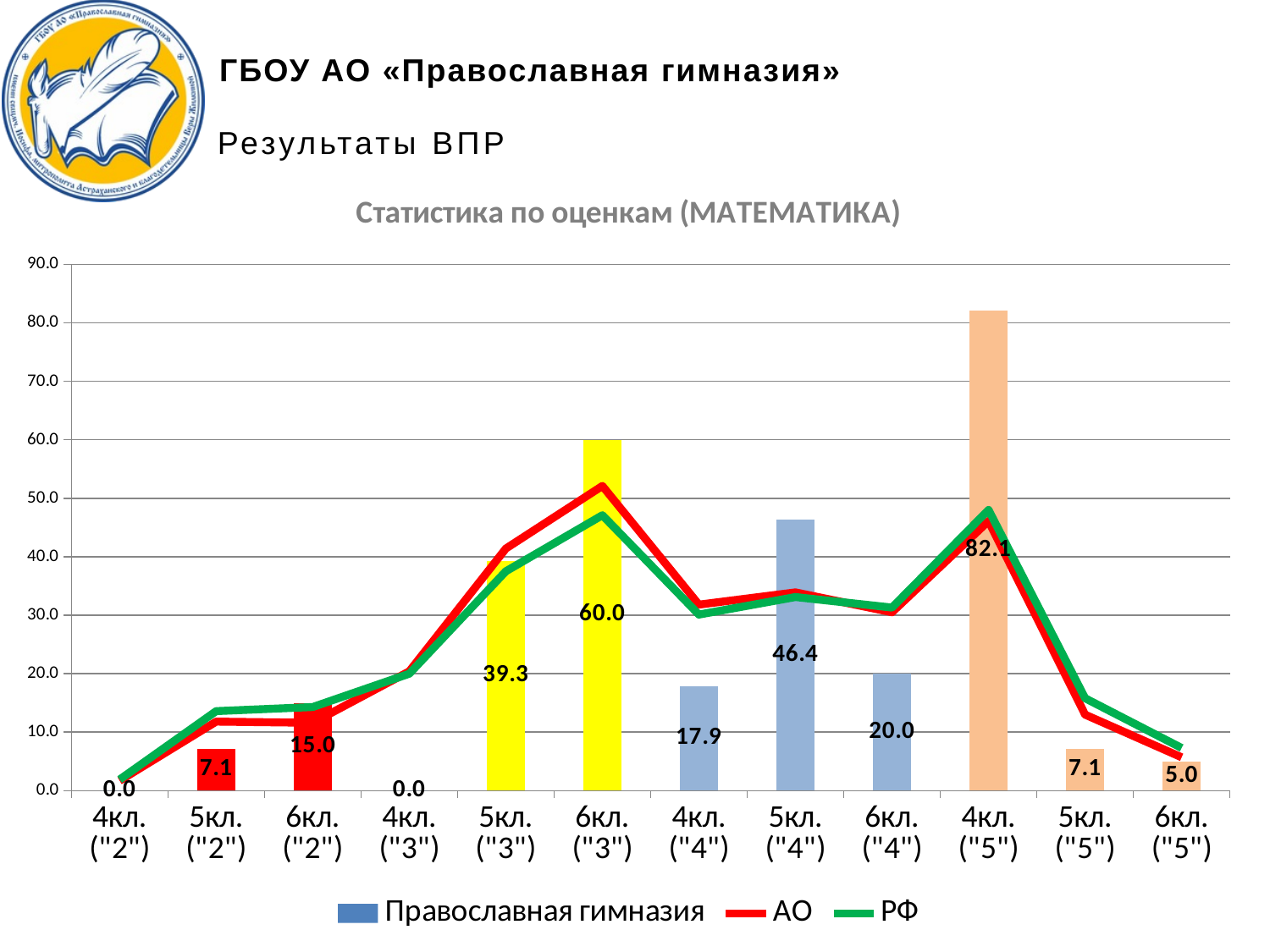
Is the РФ value for 4кл. ("3") greater or less than 30.0? less Which is larger for Православная гимназия: the value for 6кл. ("2") or the value for 5кл. ("2")? 6кл. ("2") How many series does the legend list? 3 How many categories are shown on the x axis? 12 Which category has the highest bar for Православная гимназия? 4кл. ("5") What kind of chart is used for the Православная гимназия series? bar chart What is the value for Православная гимназия in the category 5кл. ("4")? 46.4 Is the АО value for 6кл. ("3") greater or less than 50.0? greater What is the value for Православная гимназия in the category 4кл. ("5")? 82.1 What is the value for Православная гимназия in the category 6кл. ("3")? 60.0 What is the title of the chart? Статистика по оценкам (МАТЕМАТИКА) What is the difference between the Православная гимназия values for 6кл. ("3") and 5кл. ("3")? 20.7